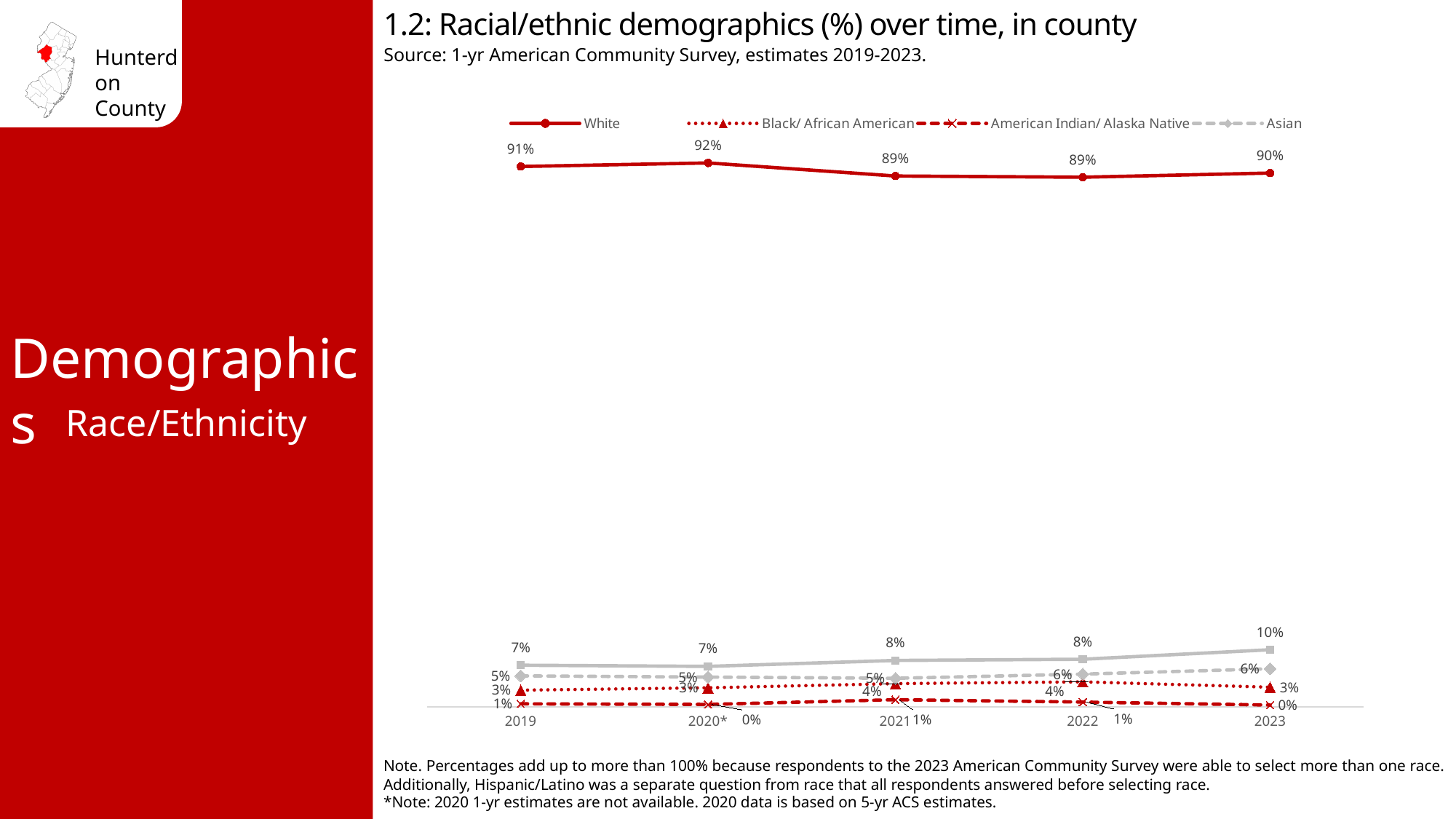
What is the value for White in 2020*? 92% What is the difference between the White value in 2020* and in 2023? 2 percentage points What is the value for White in 2019? 91% What is the value for Asian in 2023? 6% What is the title of the chart? 1.2: Racial/ethnic demographics (%) over time, in county How many years are shown on the x axis? 5 In which year is the White percentage highest? 2020* Which is larger in 2019, the Asian value or the Black/ African American value? Asian Does the Asian percentage rise or fall from 2019 to 2023? Rise What is the value for American Indian/ Alaska Native in 2023? 0% What kind of chart is shown on the slide? Line chart What is the value for Black/ African American in 2021? 4%